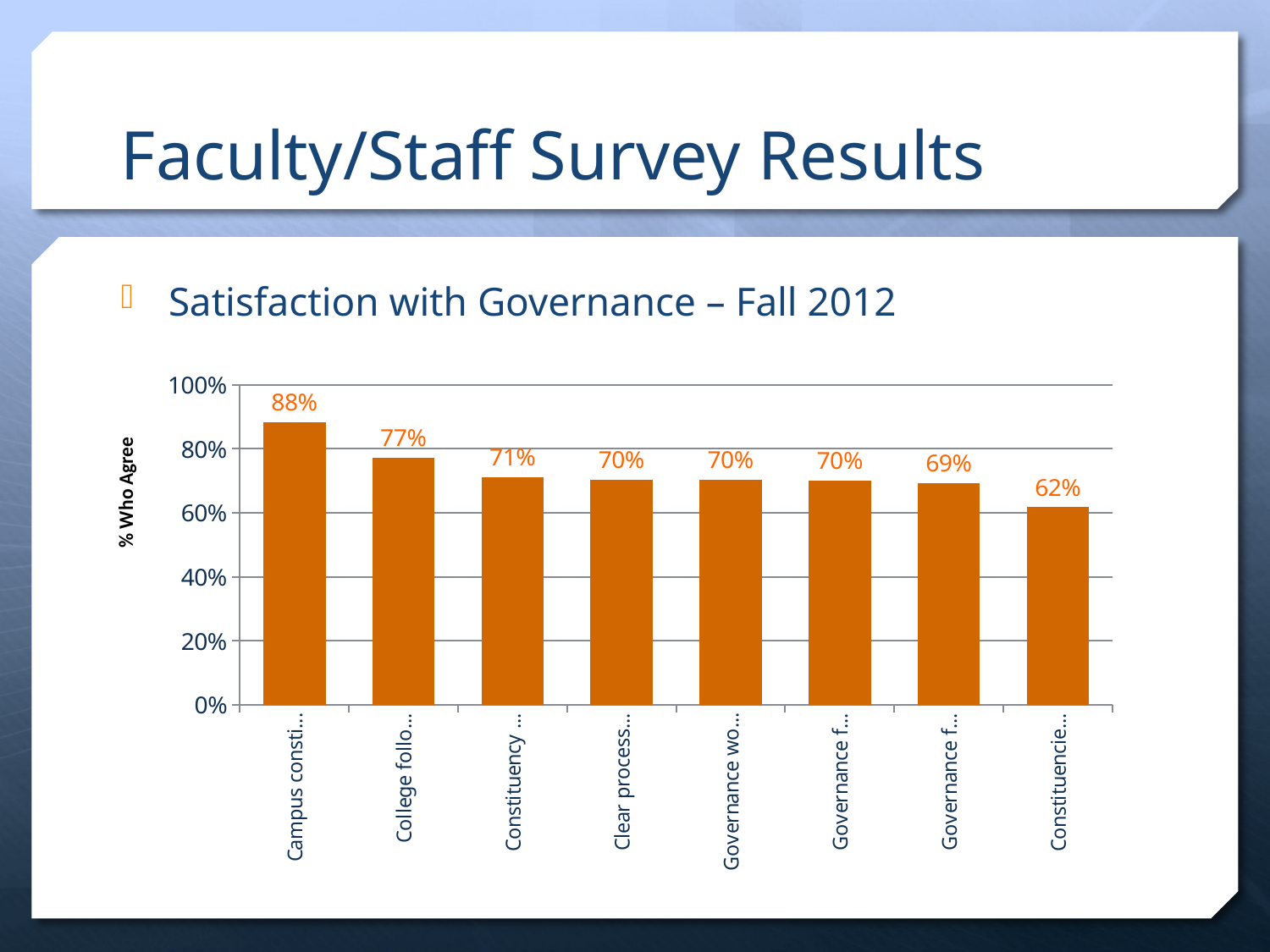
Which bar has the lowest value? Constituencie... (the last bar) What is the value of the last (rightmost) bar, labelled "Constituencie..."? 62% How many bars are plotted in the chart? 8 What is the difference between the highest bar (88%) and the lowest bar (62%)? 26% What is the label on the vertical axis? % Who Agree Which is larger, the value for "College follo..." or the value for "Constituency ..."? College follo... What is the value of the first (leftmost) bar, labelled "Campus consti..."? 88% What is the value of the second bar, labelled "College follo..."? 77% What type of chart is shown on the slide? bar chart Which bar has the highest value? Campus consti... (the first bar) Do the bar values generally rise or fall from left to right? fall What is the value of the bar labelled "Clear process..."? 70%